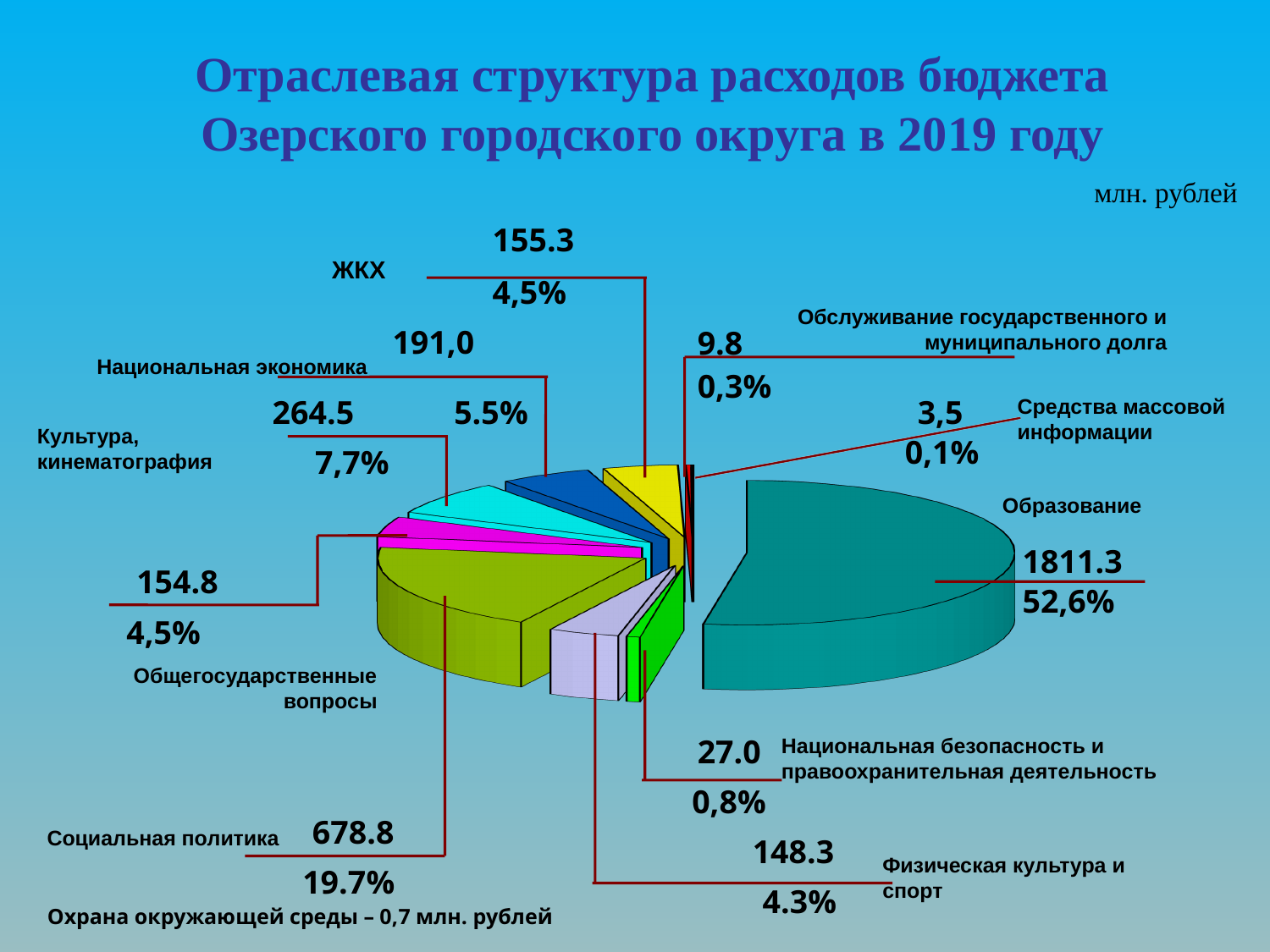
What share does Национальная экономика account for? 5.5% What is the difference between the values for Образование and Социальная политика? 1132.5 What is the value for Физическая культура и спорт? 148.3 Which category has the smallest expenditure shown in the pie chart? Средства массовой информации What kind of chart is shown on the slide? pie chart What share does Национальная безопасность и правоохранительная деятельность account for? 0,8% What is the value for Образование? 1811.3 What is the value for ЖКХ? 155.3 Which category has the largest expenditure? Образование What share of the budget expenditure does Образование account for? 52,6% In what units are the values on the chart given? млн. рублей Which is larger, the value for Культура, кинематография or the value for ЖКХ? Культура, кинематография